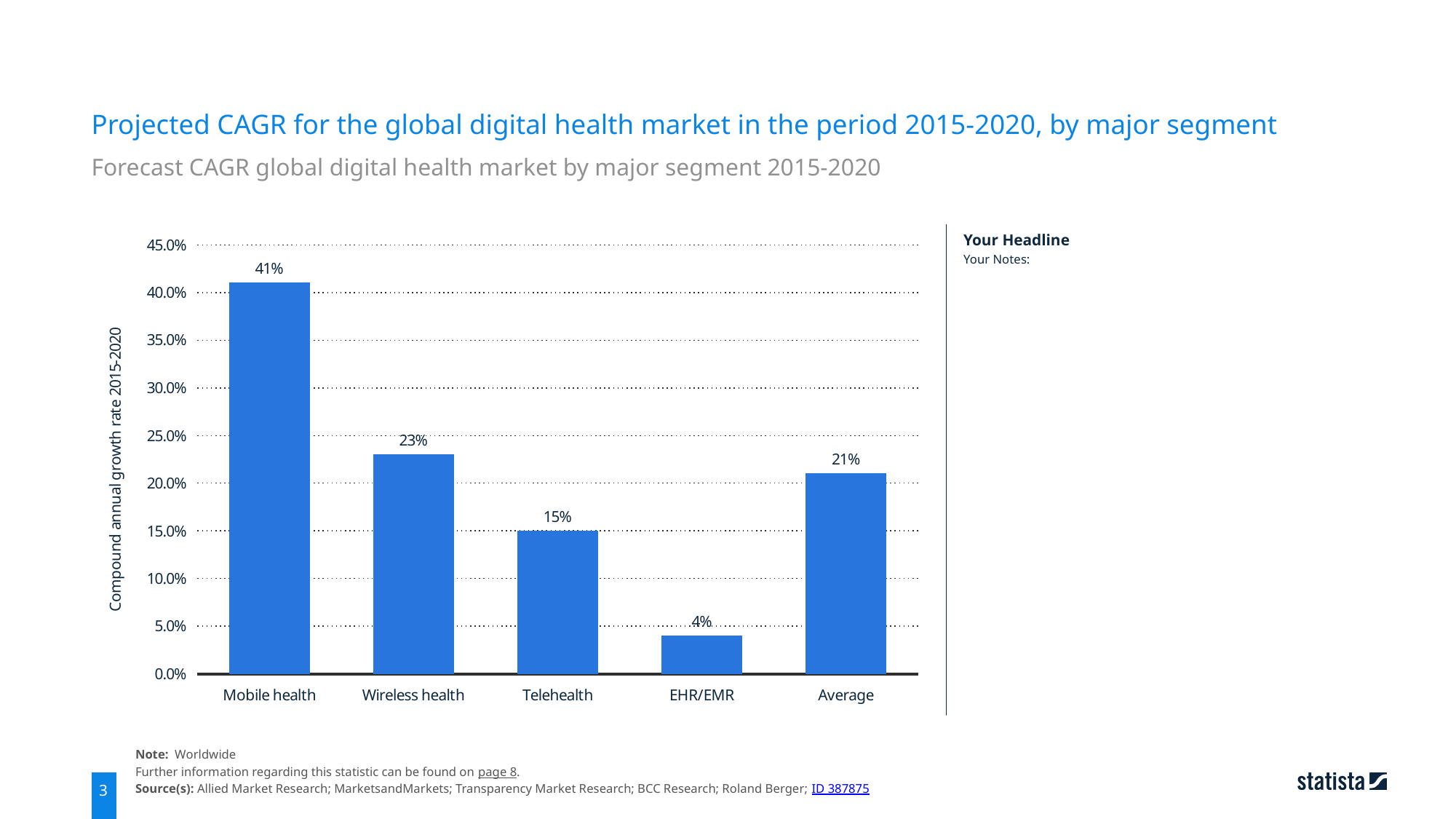
Which segment has the lowest projected CAGR? EHR/EMR Is the value for Telehealth greater or less than 20.0%? less What is the difference between the projected CAGR for Average and EHR/EMR? 17% What is the label of the y axis? Compound annual growth rate 2015-2020 How many categories are shown on the x axis? 5 What is the projected CAGR for Telehealth? 15% What kind of chart is shown on the slide? Bar chart What is the projected CAGR for Mobile health? 41% What is the projected CAGR for EHR/EMR? 4% What is the difference between the projected CAGR for Mobile health and Wireless health? 18% Which segment has the highest projected CAGR? Mobile health Which has a higher projected CAGR, Wireless health or Average? Wireless health